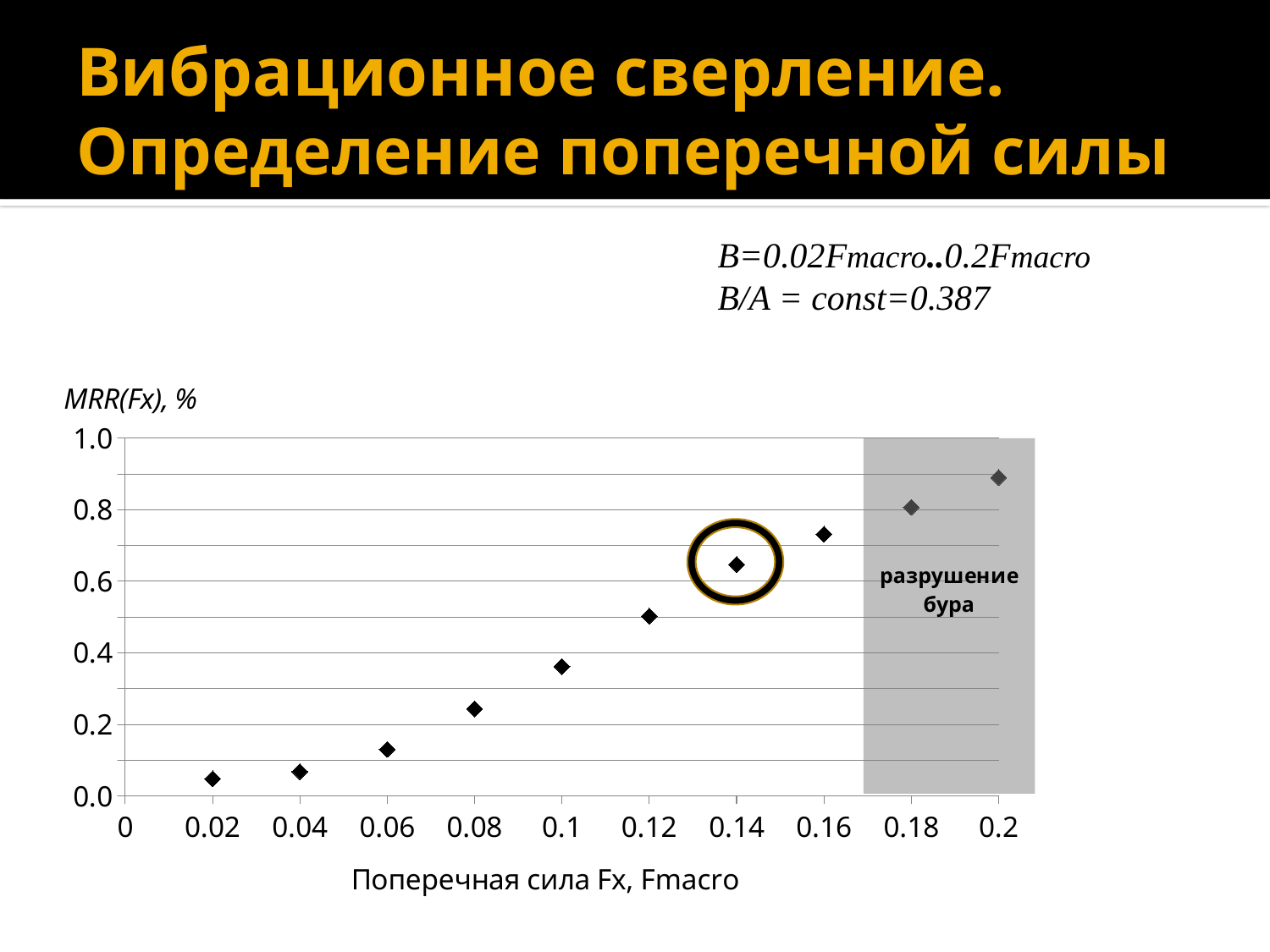
At which value of Fx is MRR(Fx) lowest? 0.02 What is the label of the x axis of the chart? Поперечная сила Fx, Fmacro Is the value of MRR(Fx) at Fx = 0.2 greater or less than 0.8? greater Is the value of MRR(Fx) at Fx = 0.14 greater or less than 0.6? greater What label is written in the shaded grey region on the right of the chart? разрушение бура What kind of chart is shown on the slide? scatter chart Is the value of MRR(Fx) at Fx = 0.08 greater or less than 0.4? less How many data points are plotted on the chart? 10 Which has the larger MRR(Fx) value: Fx = 0.1 or Fx = 0.16? 0.16 At which value of Fx is MRR(Fx) highest? 0.2 Do the MRR(Fx) values rise or fall as the transverse force Fx increases along the x axis? rise